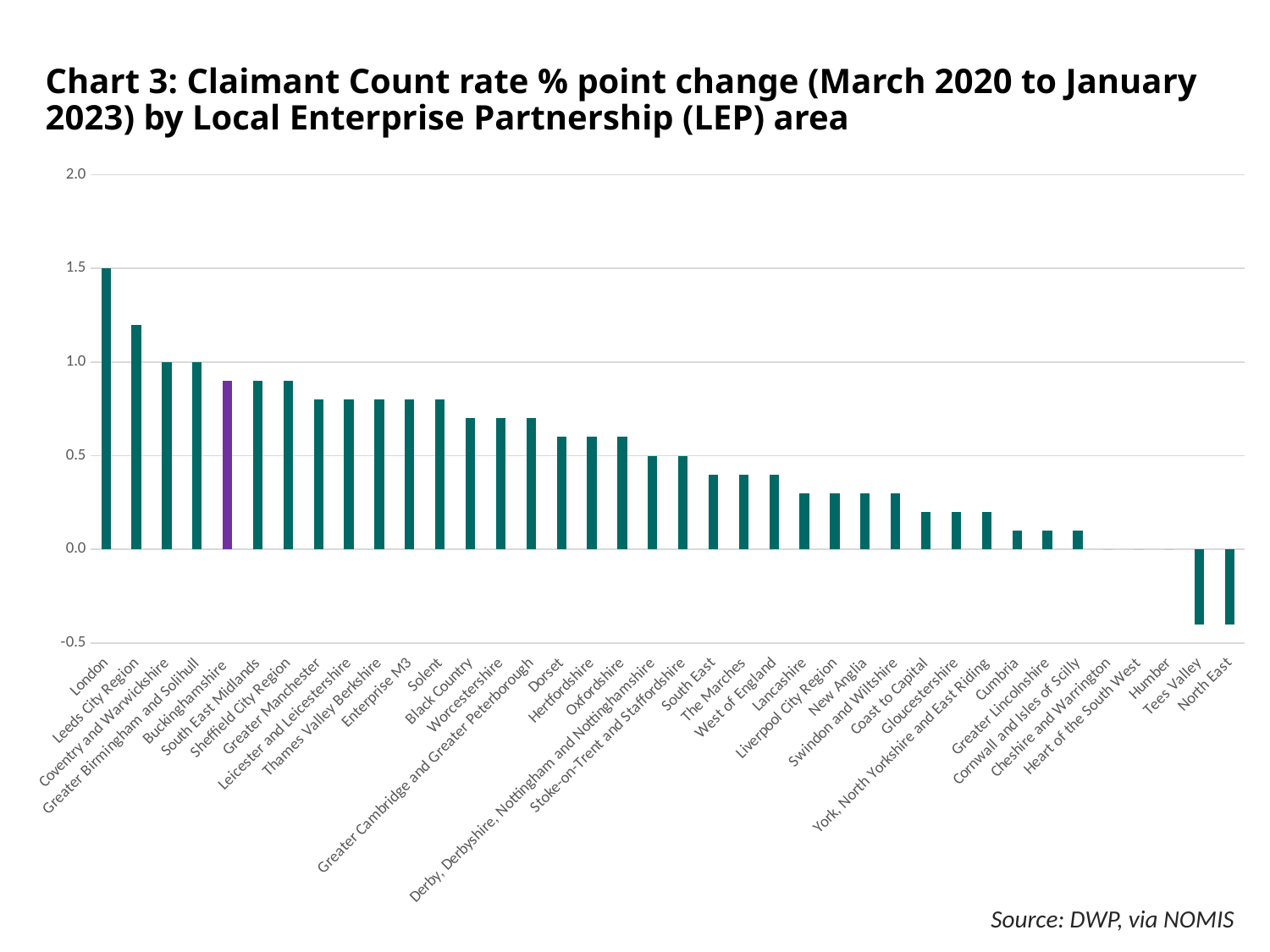
What is the Claimant Count rate % point change for Heart of the South West? 0.0 Do the values rise or fall moving from left to right along the x axis? fall What is the Claimant Count rate % point change for London? 1.5 Which LEP area has the highest Claimant Count rate % point change? London Which is larger, the value for London or the value for Leeds City Region? London Which LEP area's bar is highlighted in purple rather than green? Buckinghamshire How many LEP areas have a negative Claimant Count rate % point change? 2 What kind of chart is shown on the slide? bar chart Is the value for Cumbria greater or less than 0.5? less What is the Claimant Count rate % point change for Coventry and Warwickshire? 1.0 Is the value for Leeds City Region greater or less than 1.0? greater What is the difference between the values for London and Greater Birmingham and Solihull? 0.5